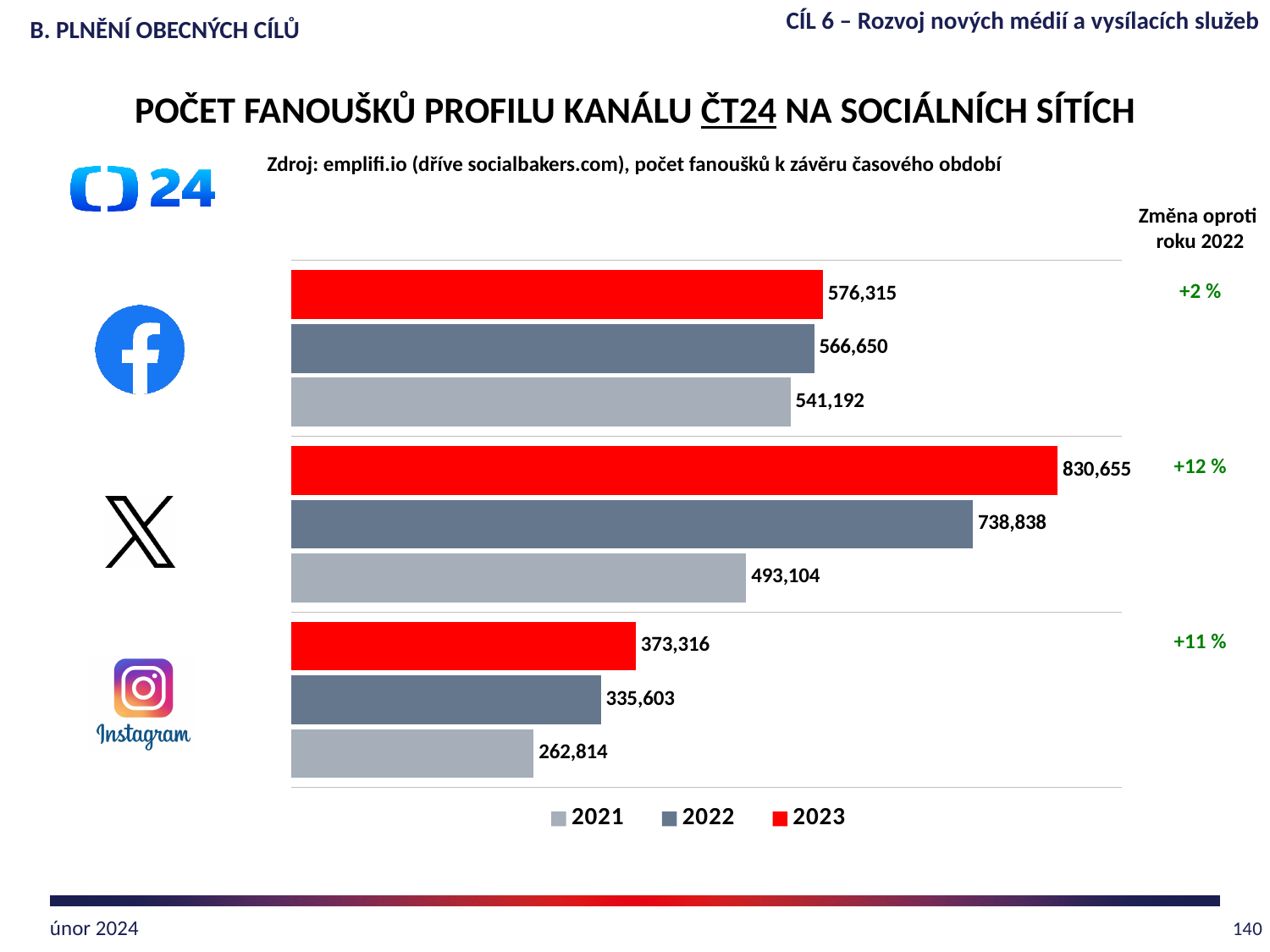
What kind of chart is shown on the slide? bar chart What percentage change compared to 2022 is shown for Instagram? +11 % Which social network has the highest number of ČT24 fans in 2023? X What is the difference between the 2023 and 2022 number of ČT24 fans on X? 91,817 What is the number of ČT24 Instagram fans in 2023? 373,316 Do the ČT24 Facebook fan counts rise or fall from 2021 to 2023? rise What is the difference between the 2022 and 2021 number of ČT24 Instagram fans? 72,789 How many series does the legend list? 3 Which is larger: the 2023 Facebook fan count or the 2023 Instagram fan count? 2023 Facebook fan count Which social network has the lowest number of ČT24 fans in 2021? Instagram What is the number of ČT24 Facebook fans in 2021? 541,192 What is the number of ČT24 fans on X in 2022? 738,838